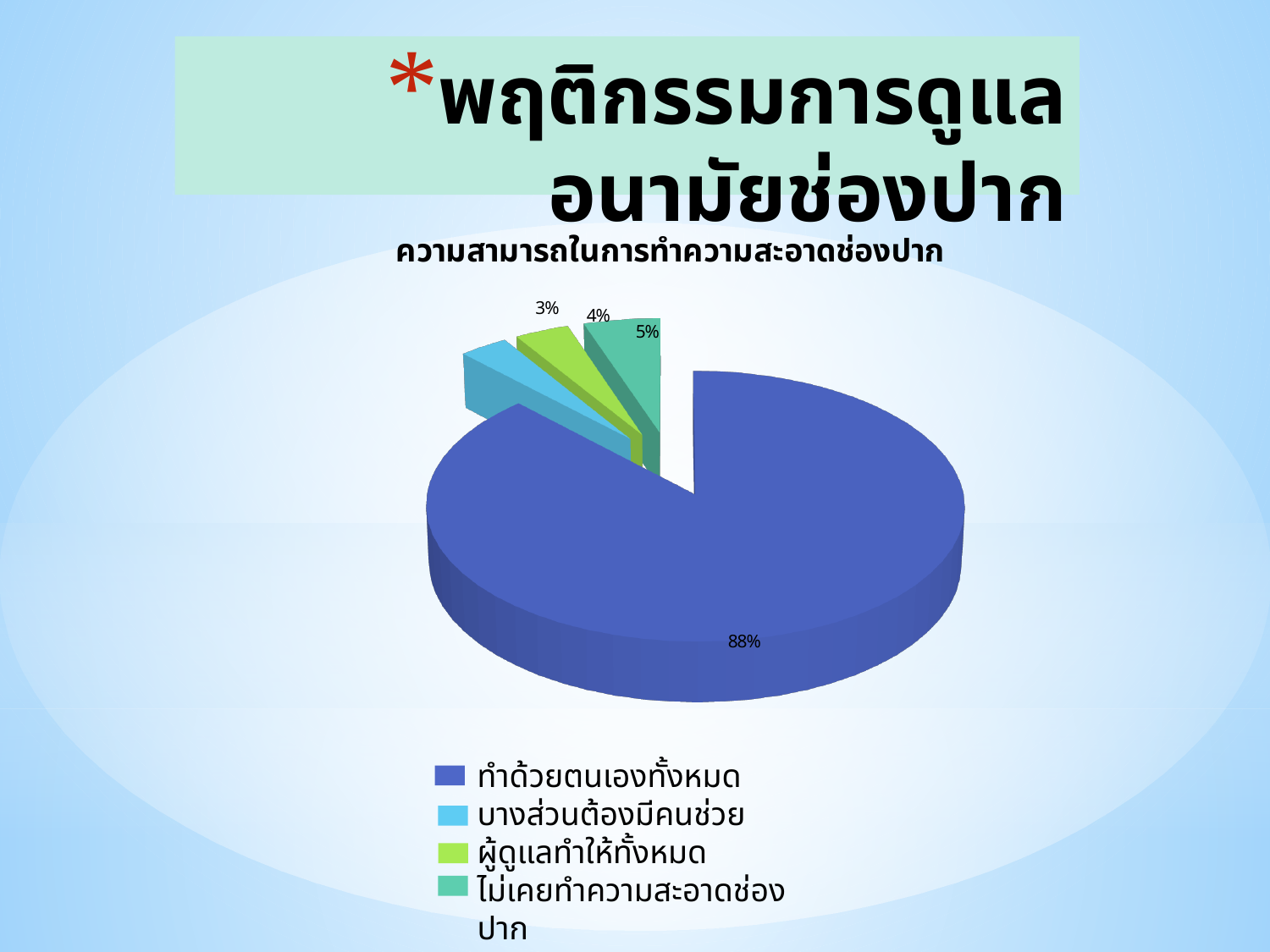
What percentage is shown for ไม่เคยทำความสะอาดช่องปาก? 5% What kind of chart is shown on the slide? Pie chart What is the title of the chart? ความสามารถในการทำความสะอาดช่องปาก How many entries does the legend list? 4 Which category has the smallest share of the pie? บางส่วนต้องมีคนช่วย What percentage is shown for ผู้ดูแลทำให้ทั้งหมด? 4% Which is larger, the share for ผู้ดูแลทำให้ทั้งหมด or the share for ไม่เคยทำความสะอาดช่องปาก? ไม่เคยทำความสะอาดช่องปาก What is the difference in percentage points between ทำด้วยตนเองทั้งหมด and ไม่เคยทำความสะอาดช่องปาก? 83 Which category has the largest share of the pie? ทำด้วยตนเองทั้งหมด How many slices does the pie chart have? 4 What percentage is shown for บางส่วนต้องมีคนช่วย? 3% What percentage is shown for ทำด้วยตนเองทั้งหมด? 88%